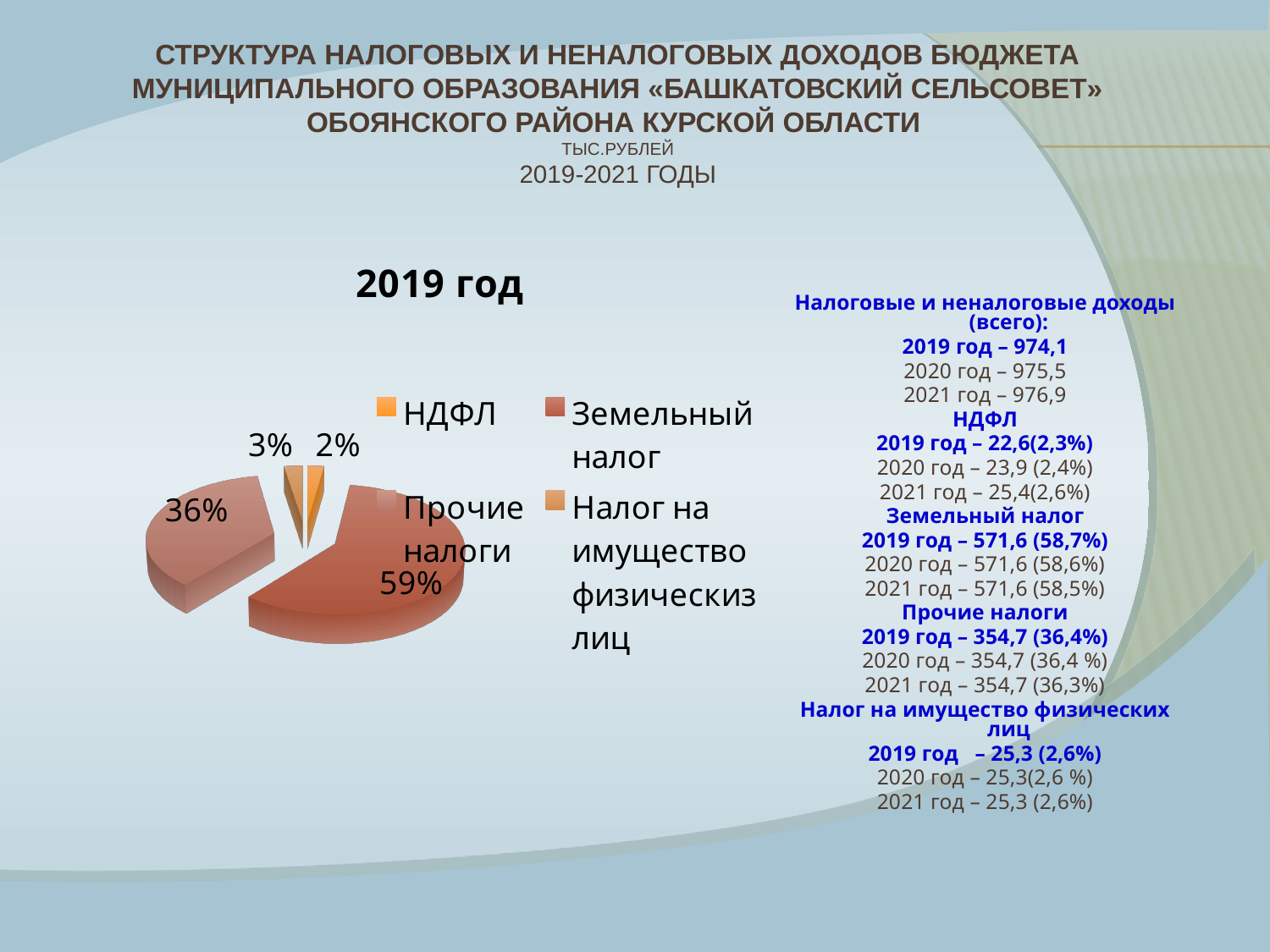
Which slice is larger, Земельный налог or Прочие налоги? Земельный налог What percentage is shown for НДФЛ in the pie chart? 2% What kind of chart is shown on the slide? pie chart How many entries does the pie chart's legend list? 4 What share of the pie does Земельный налог take? 59% What is the difference in percentage points between the Земельный налог slice and the Прочие налоги slice? 23 Which category has the largest slice in the pie chart? Земельный налог Which category has the smallest slice in the pie chart? НДФЛ What percentage is shown for Прочие налоги in the pie chart? 36% What is the title of the pie chart? 2019 год What percentage is shown for Налог на имущество физических лиц in the pie chart? 3% How many slices does the pie chart have? 4